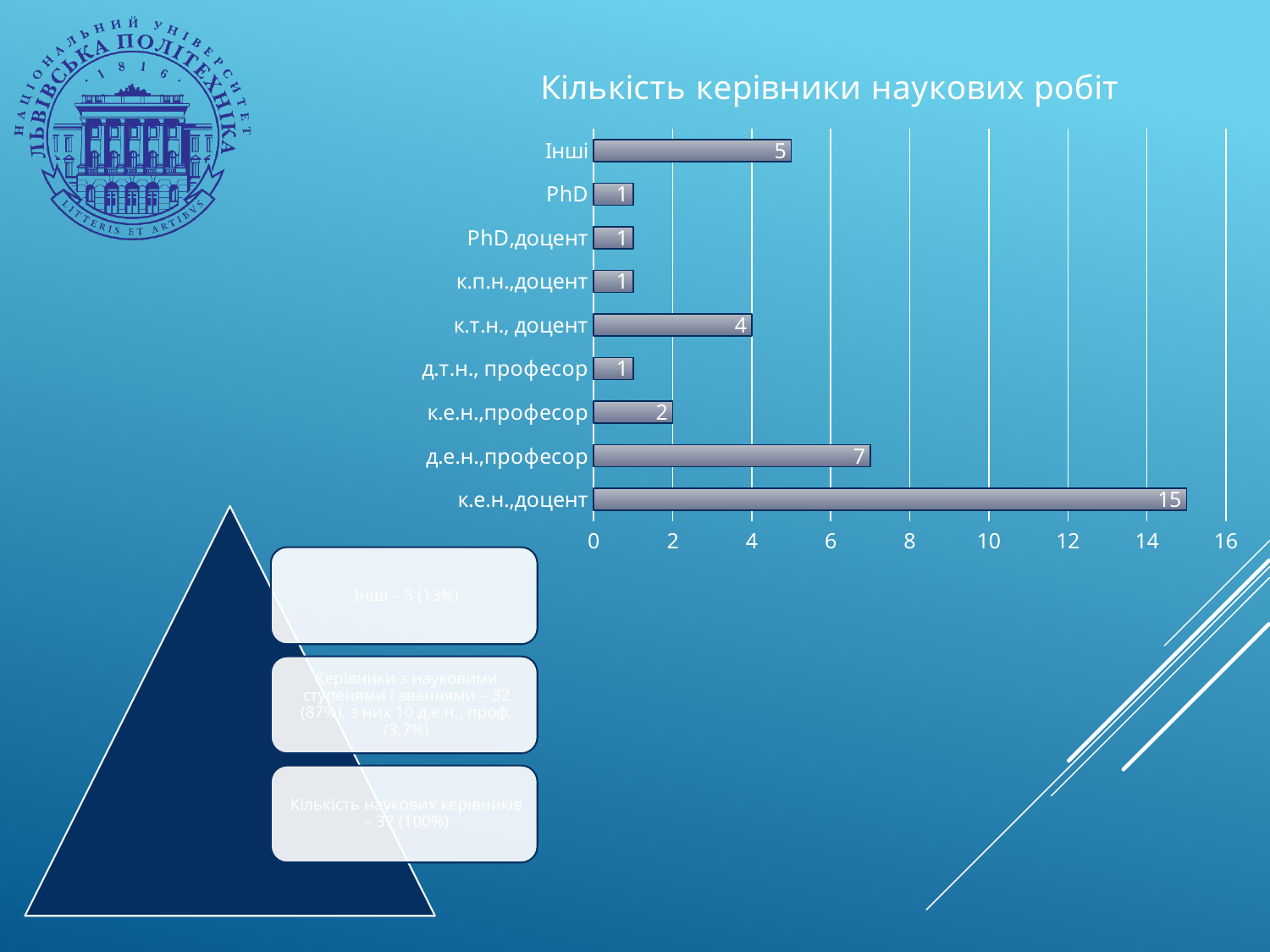
What is the value for Інші? 5 Which is larger, the value for Інші or the value for к.т.н., доцент? Інші How many categories are shown in the chart? 9 What is the difference between the values for к.е.н.,доцент and д.е.н.,професор? 8 Is the value for к.е.н.,доцент greater or less than 14? greater What is the value for к.е.н.,доцент? 15 What kind of chart is shown on the slide? bar chart What is the value for к.т.н., доцент? 4 What is the value for к.е.н.,професор? 2 What is the value for д.е.н.,професор? 7 Which category has the highest value? к.е.н.,доцент What is the title of the chart? Кількість керівники наукових робіт